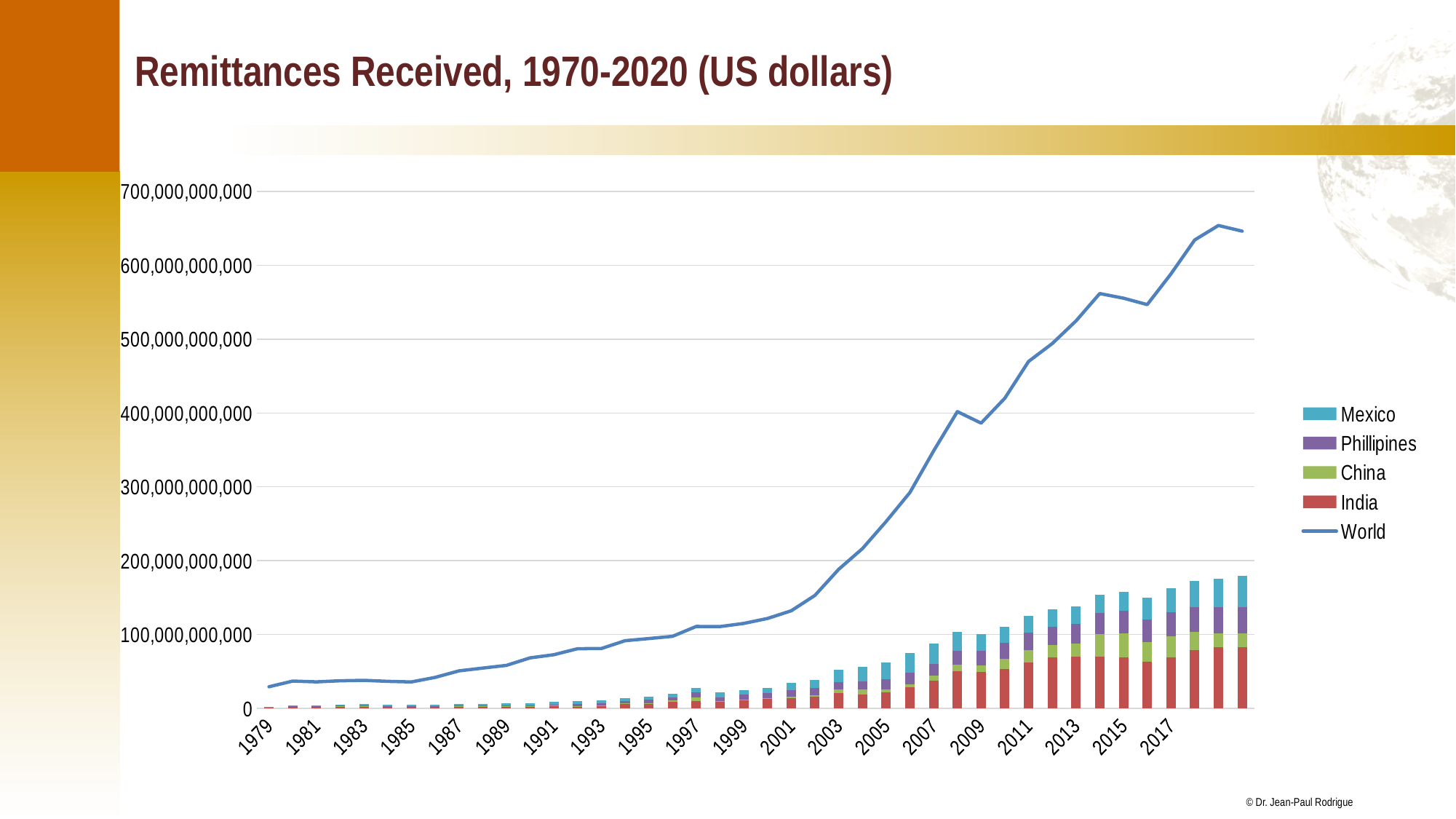
How many series does the legend list? 5 Is the World value for 2015 greater or less than 500,000,000,000? greater Which series is drawn as a line rather than as bars? World Is the World value for 1991 greater or less than 100,000,000,000? less In 2017, which is larger: the World line value or the total of the stacked bar? World Is the World value for 2001 greater or less than 100,000,000,000? greater Does the World line generally rise or fall from 1979 to 2017? rise What kind of chart is shown on the slide? A combination chart with stacked bars and a line Which series forms the bottom segment of each stacked bar? India